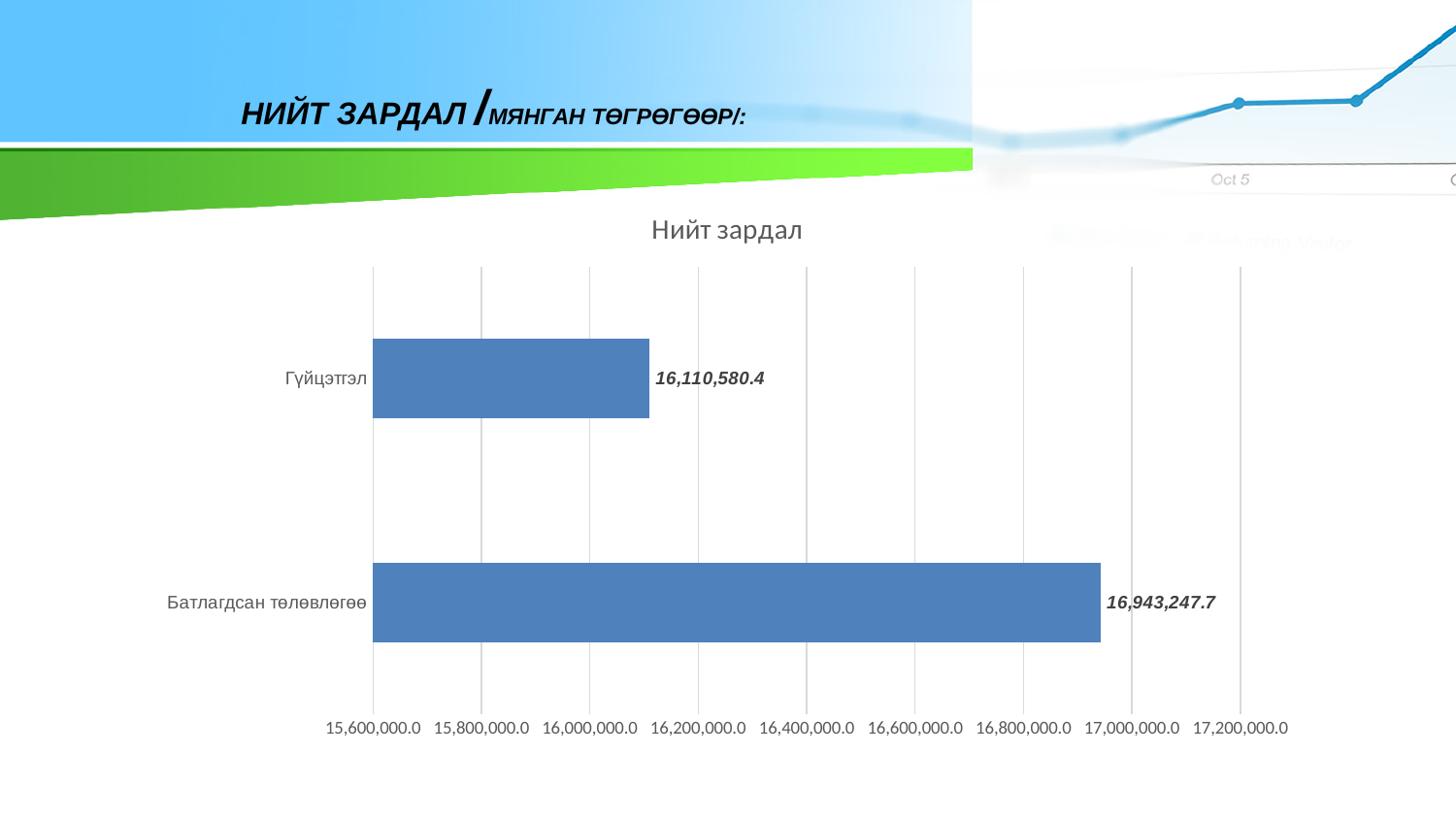
What is the value for Батлагдсан төлөвлөгөө in the chart? 16,943,247.7 What is the title of the chart? Нийт зардал Which category has the lowest value in the chart? Гүйцэтгэл Is the value for Гүйцэтгэл greater or less than 16,200,000.0? less What is the difference between the values for Батлагдсан төлөвлөгөө and Гүйцэтгэл? 832,667.3 Is the value for Батлагдсан төлөвлөгөө greater or less than 16,800,000.0? greater Which is larger, the value for Гүйцэтгэл or the value for Батлагдсан төлөвлөгөө? Батлагдсан төлөвлөгөө How many categories are shown in the chart? 2 What kind of chart is shown on the slide? bar chart Which category has the highest value in the chart? Батлагдсан төлөвлөгөө What is the value for Гүйцэтгэл in the chart? 16,110,580.4 What is the highest value shown on the horizontal axis of the chart? 17,200,000.0